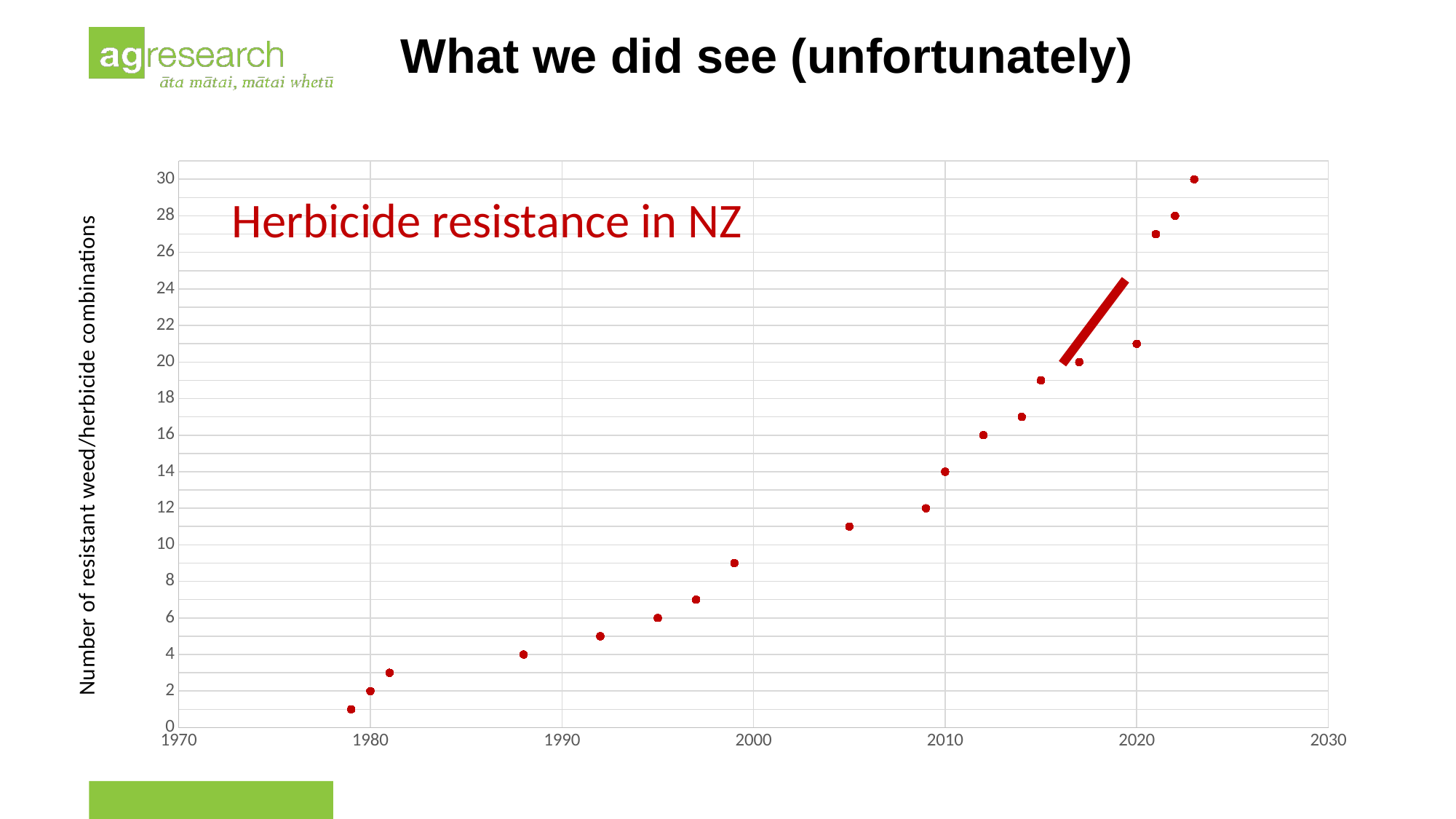
What kind of chart is shown on the slide? scatter chart Is the value of the lowest point on the chart greater or less than 2? less What is the title shown inside the chart area? Herbicide resistance in NZ What is the label of the y axis? Number of resistant weed/herbicide combinations Do the plotted values rise or fall as the years increase along the x axis? rise Is the value of the point plotted just before 2000 greater or less than 10? less How many data points are plotted on the chart? 19 Is the value of the point plotted at 2020 greater or less than 20? greater What is the value of the point plotted at 2010? 14 Which is larger: the value of the point at 2010 or the value of the point at 2020? 2020 What is the value of the highest point on the chart? 30